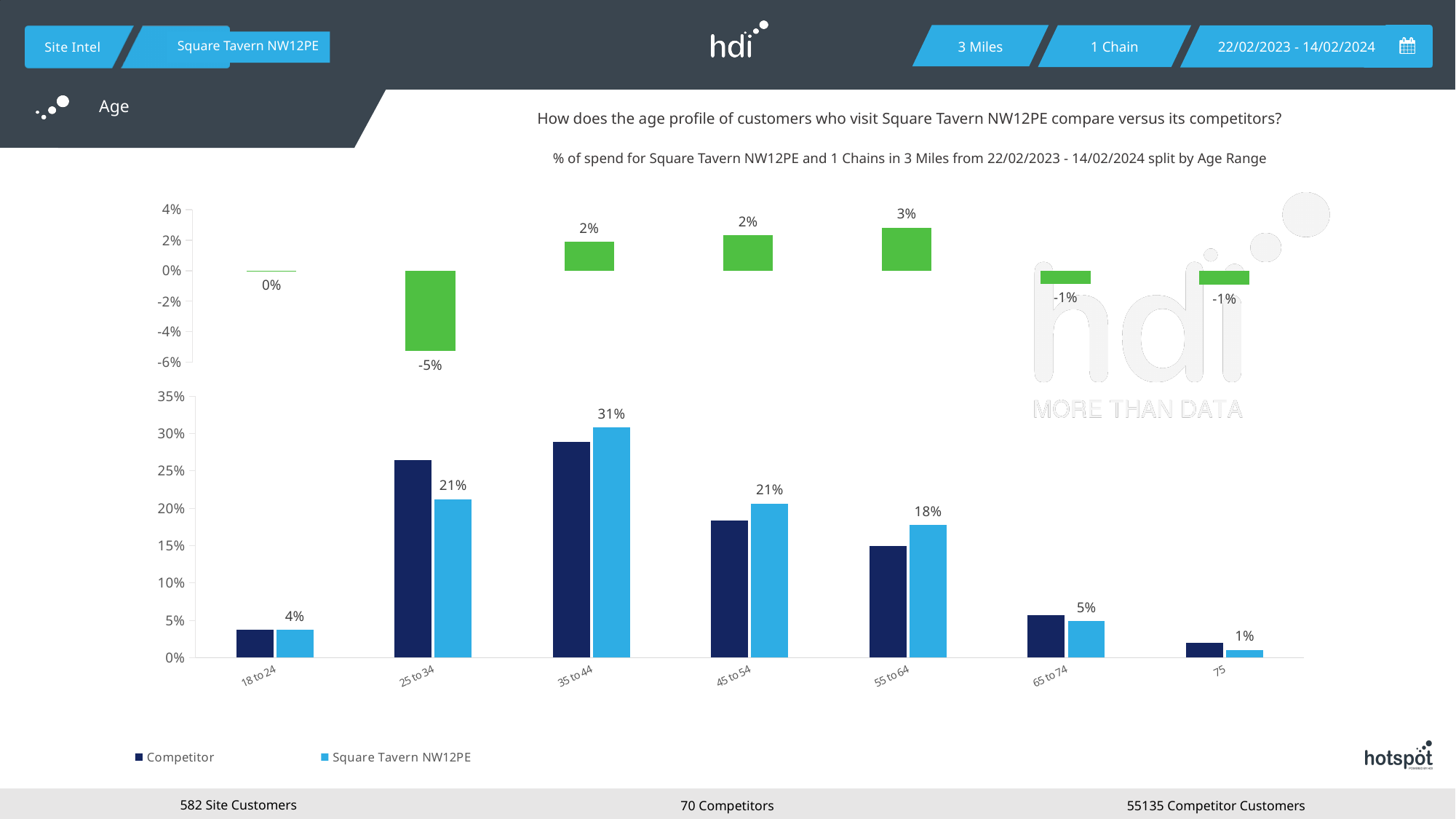
In the top chart, what is the value for the 25 to 34 age range? -5% In the bottom chart, which is larger for the 25 to 34 age range: Competitor or Square Tavern NW12PE? Competitor In the bottom chart, is the Competitor value for 25 to 34 greater or less than 25%? greater In the bottom chart, what is the value for Square Tavern NW12PE in the 55 to 64 age range? 18% In the bottom chart, what is the difference between the Square Tavern NW12PE values for 35 to 44 and 25 to 34? 10% How many series does the legend of the bottom chart list? 2 In the bottom chart, which age range has the lowest value for Square Tavern NW12PE? 75 In the bottom chart, which age range has the highest value for Square Tavern NW12PE? 35 to 44 In the top chart, which age range has the highest value? 55 to 64 In the bottom chart, what is the value for Square Tavern NW12PE in the 35 to 44 age range? 31% How many age range categories are shown on the x axis of the bottom chart? 7